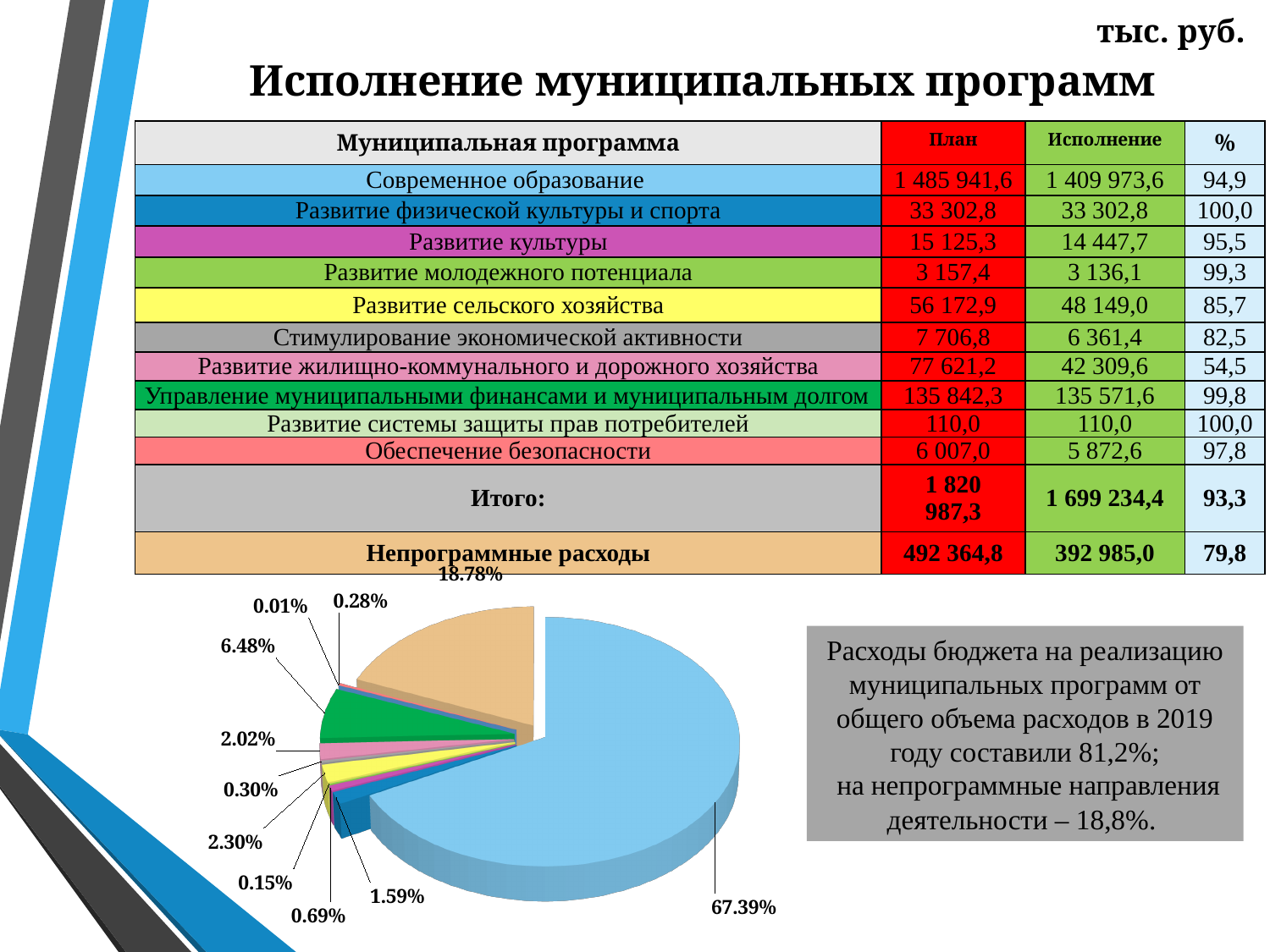
What kind of chart is shown at the bottom of the slide? pie chart What is the value of the largest slice in the pie chart? 67.39% What is the value of the second-largest slice in the pie chart? 18.78% Is the largest slice of the pie chart greater or less than 50%? greater How many slices does the pie chart have? 11 What is the combined share of the two largest slices (67.39% and 18.78%) in the pie chart? 86.17% In the pie chart, which is larger: the slice labelled 6.48% or the slice labelled 2.02%? 6.48% What is the value of the tan-coloured slice in the pie chart? 18.78% What colour is the largest slice of the pie chart? light blue What is the value of the smallest slice in the pie chart? 0.01% What is the difference between the largest slice (67.39%) and the second-largest slice (18.78%) in the pie chart? 48.61% What is the value of the green slice in the pie chart? 6.48%